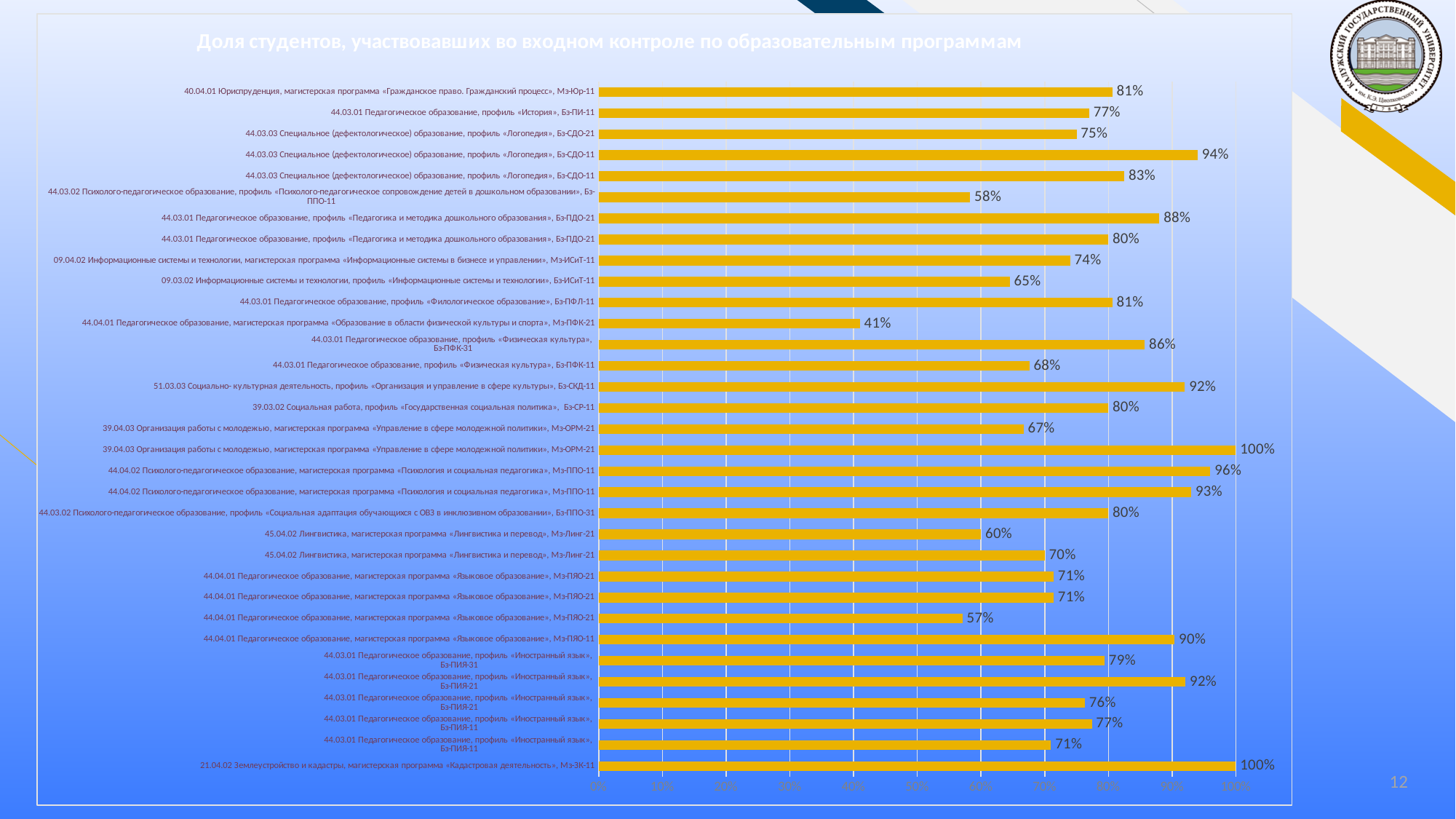
What is the value for 21.04.02 Землеустройство и кадастры, магистерская программа «Кадастровая деятельность», Мз-ЗК-11? 100% What is the value for 44.03.02 Психолого-педагогическое образование, профиль «Психолого-педагогическое сопровождение детей в дошкольном образовании», Бз-ППО-11? 58% How many programs (bars) are shown in the chart? 33 What is the value for 51.03.03 Социально-культурная деятельность, профиль «Организация и управление в сфере культуры», Бз-СКД-11? 92% What is the difference between the values for Бз-ПФК-31 (44.03.01 Педагогическое образование, профиль «Физическая культура») and Бз-ПФК-11? 18% What is the title of the chart? Доля студентов, участвовавших во входном контроле по образовательным программам Which program has the lowest share of students who took part in the entrance control? 44.04.01 Педагогическое образование, магистерская программа «Образование в области физической культуры и спорта», Мз-ПФК-21 What kind of chart is shown on the slide? Bar chart What is the value for 09.03.02 Информационные системы и технологии, профиль «Информационные системы и технологии», Бз-ИСиТ-11? 65% Which is larger: the value for 40.04.01 Юриспруденция, Мз-Юр-11 or the value for 44.03.01 Педагогическое образование, профиль «История», Бз-ПИ-11? 40.04.01 Юриспруденция, Мз-Юр-11 What is the difference between the values for 09.04.02 Информационные системы и технологии, Мз-ИСиТ-11 and 09.03.02 Информационные системы и технологии, Бз-ИСиТ-11? 9% What is the value for 44.04.01 Педагогическое образование, магистерская программа «Образование в области физической культуры и спорта», Мз-ПФК-21? 41%